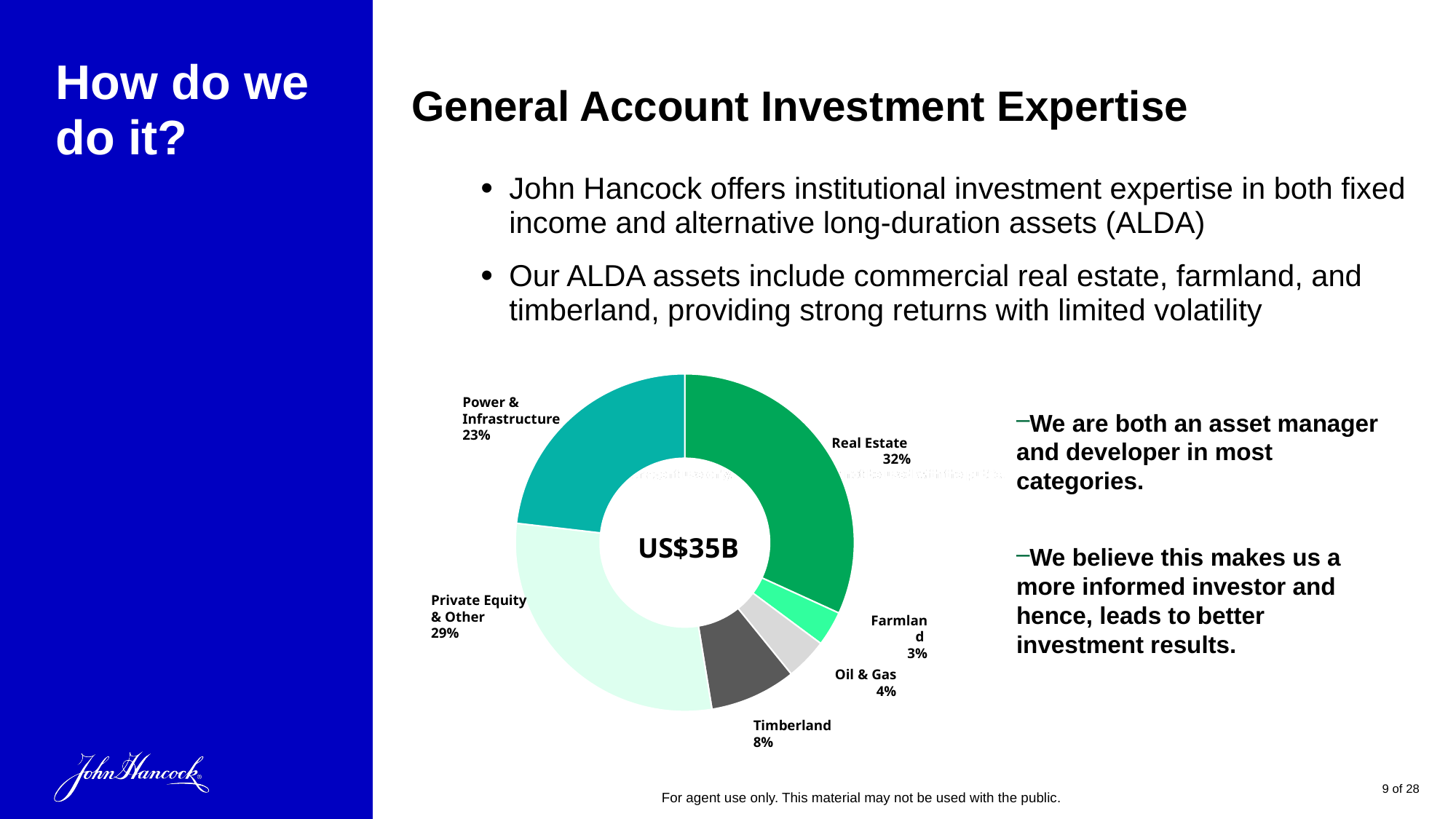
Which category has the smallest share in the chart? Farmland What share of the donut chart does Real Estate represent? 32% What percentage is shown for Power & Infrastructure in the chart? 23% What percentage is shown for Farmland in the chart? 3% How many categories are shown in the donut chart? 6 What is the combined share of Real Estate and Private Equity & Other? 61% What total value is printed in the centre of the donut chart? US$35B What is the difference in percentage points between Private Equity & Other and Power & Infrastructure? 6 What kind of chart is shown on the slide? Donut (pie) chart Which is larger, the share for Oil & Gas or the share for Timberland? Timberland Which category has the largest share in the chart? Real Estate What percentage is shown for Timberland in the chart? 8%